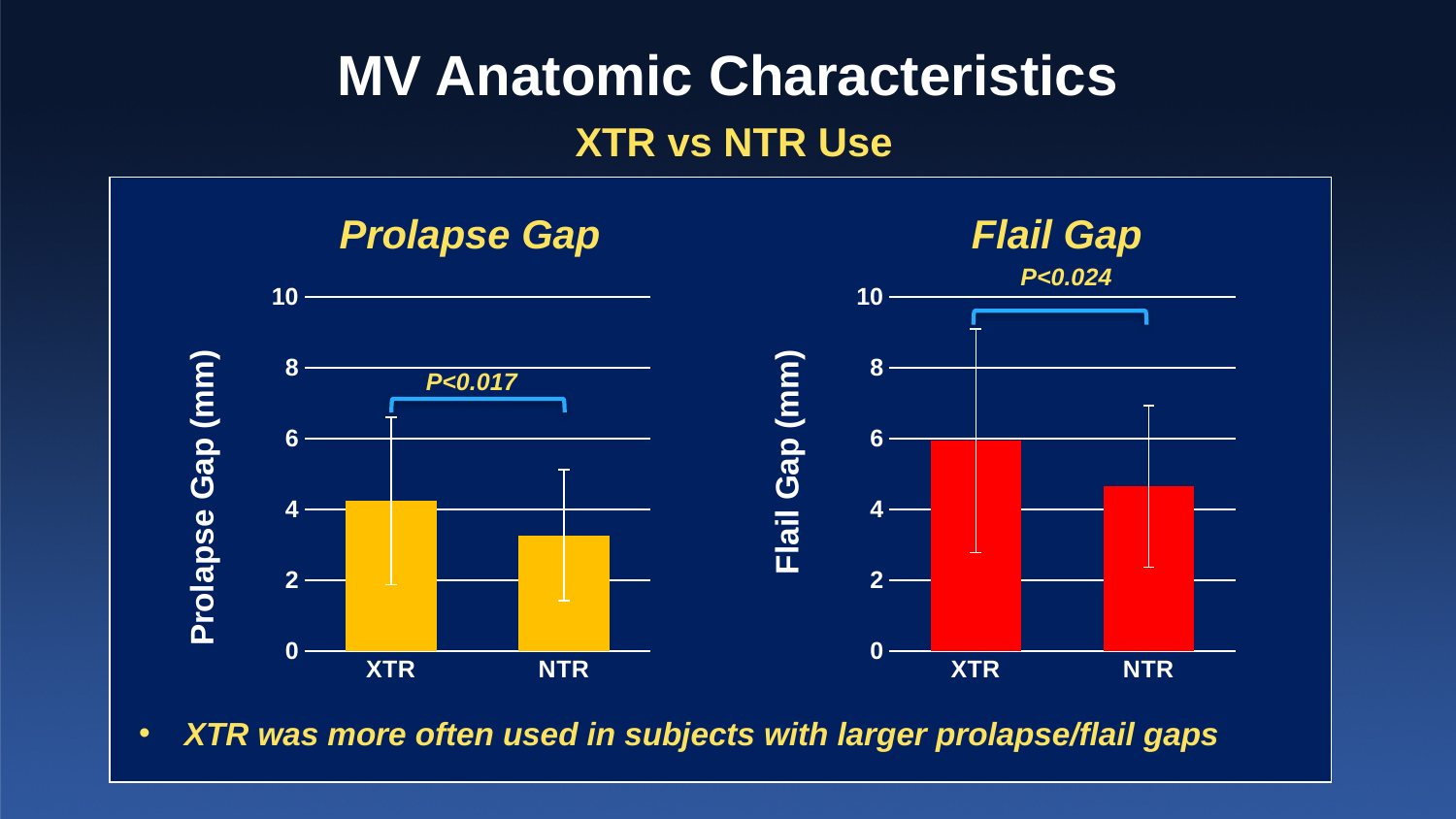
In the Flail Gap chart, which category has the highest bar? XTR What kind of chart is the Prolapse Gap chart? Bar chart In the Flail Gap chart, which category has the lowest bar? NTR What is the y-axis label of the Prolapse Gap chart? Prolapse Gap (mm) How many categories are shown on the x axis of the Flail Gap chart? 2 In the Prolapse Gap chart, which category has the higher bar, XTR or NTR? XTR In the Flail Gap chart, is the value for NTR greater or less than 4? greater In the Prolapse Gap chart, is the value for XTR greater or less than 6? less In the Prolapse Gap chart, is the value for NTR greater or less than 4? less What P value is shown above the bars in the Flail Gap chart? P<0.024